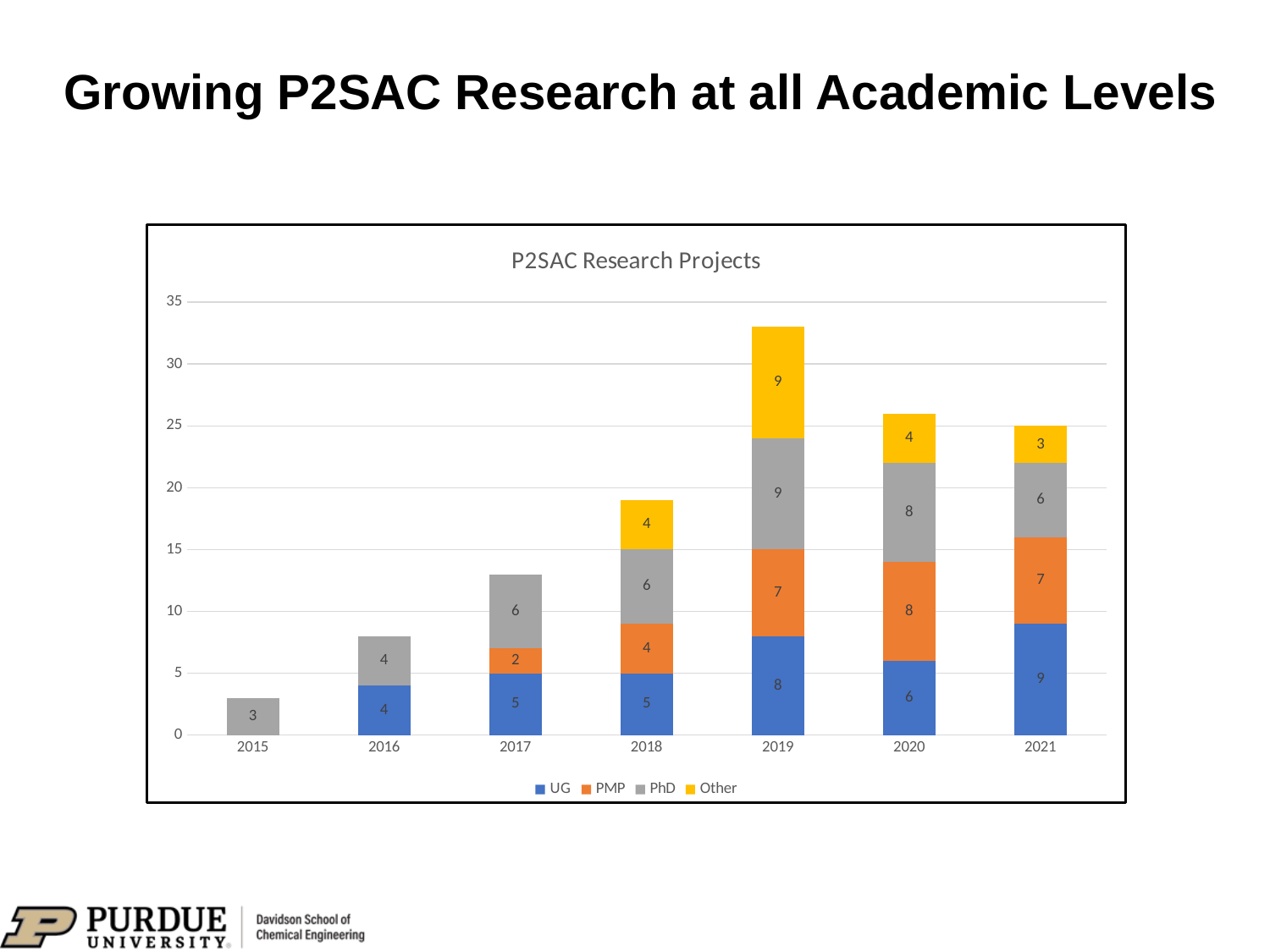
What is the difference between the PMP values for 2020 and 2017? 6 Which year has the highest total stacked bar? 2019 Which is larger, the UG value for 2021 or the UG value for 2020? 2021 What is the PhD value for 2015? 3 What is the UG value for 2019? 8 How many series does the legend list? 4 What is the total of the stacked bar for 2018? 19 What is the title of the chart? P2SAC Research Projects How many years are shown on the x axis? 7 What is the Other value for 2021? 3 What is the total of the stacked bar for 2019? 33 What type of chart is shown on the slide? Stacked bar chart